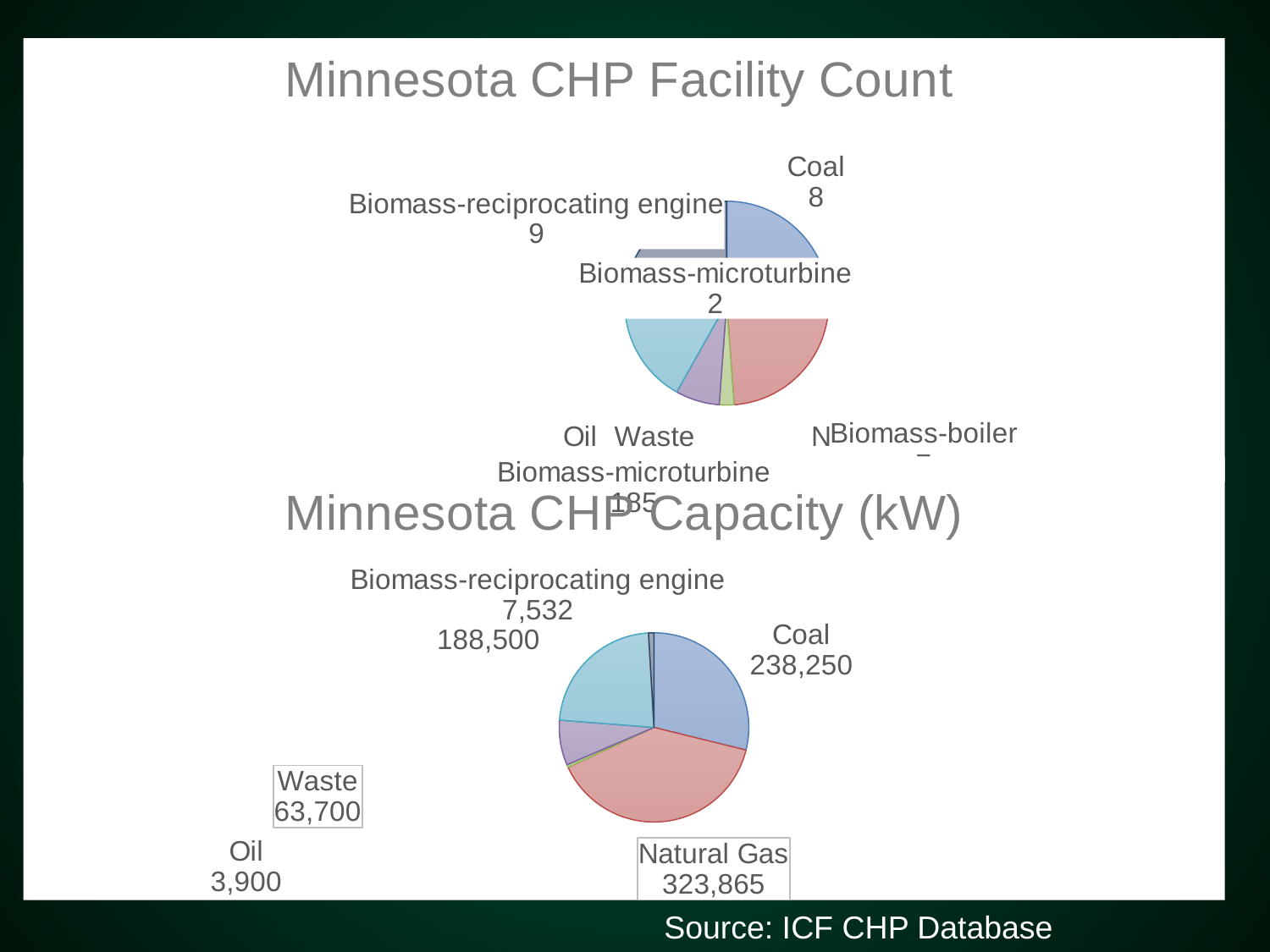
In the Minnesota CHP Capacity (kW) chart, what is the value for Coal? 238,250 In the Minnesota CHP Capacity (kW) chart, what is the difference between Natural Gas and Coal? 85,615 In the Minnesota CHP Facility Count chart, what is the value for Coal? 8 What source is cited at the bottom of the slide? ICF CHP Database In the Minnesota CHP Capacity (kW) chart, what is the value for Waste? 63,700 In the Minnesota CHP Capacity (kW) chart, which category has the highest value? Natural Gas What kind of chart is the Minnesota CHP Facility Count chart? pie chart In the Minnesota CHP Capacity (kW) chart, what is the value for Natural Gas? 323,865 In the Minnesota CHP Facility Count chart, what is the value for Biomass-microturbine? 2 In the Minnesota CHP Facility Count chart, what is the value for Biomass-reciprocating engine? 9 In the Minnesota CHP Facility Count chart, which is larger, Coal or Biomass-reciprocating engine? Biomass-reciprocating engine How many charts are shown on the slide? 2